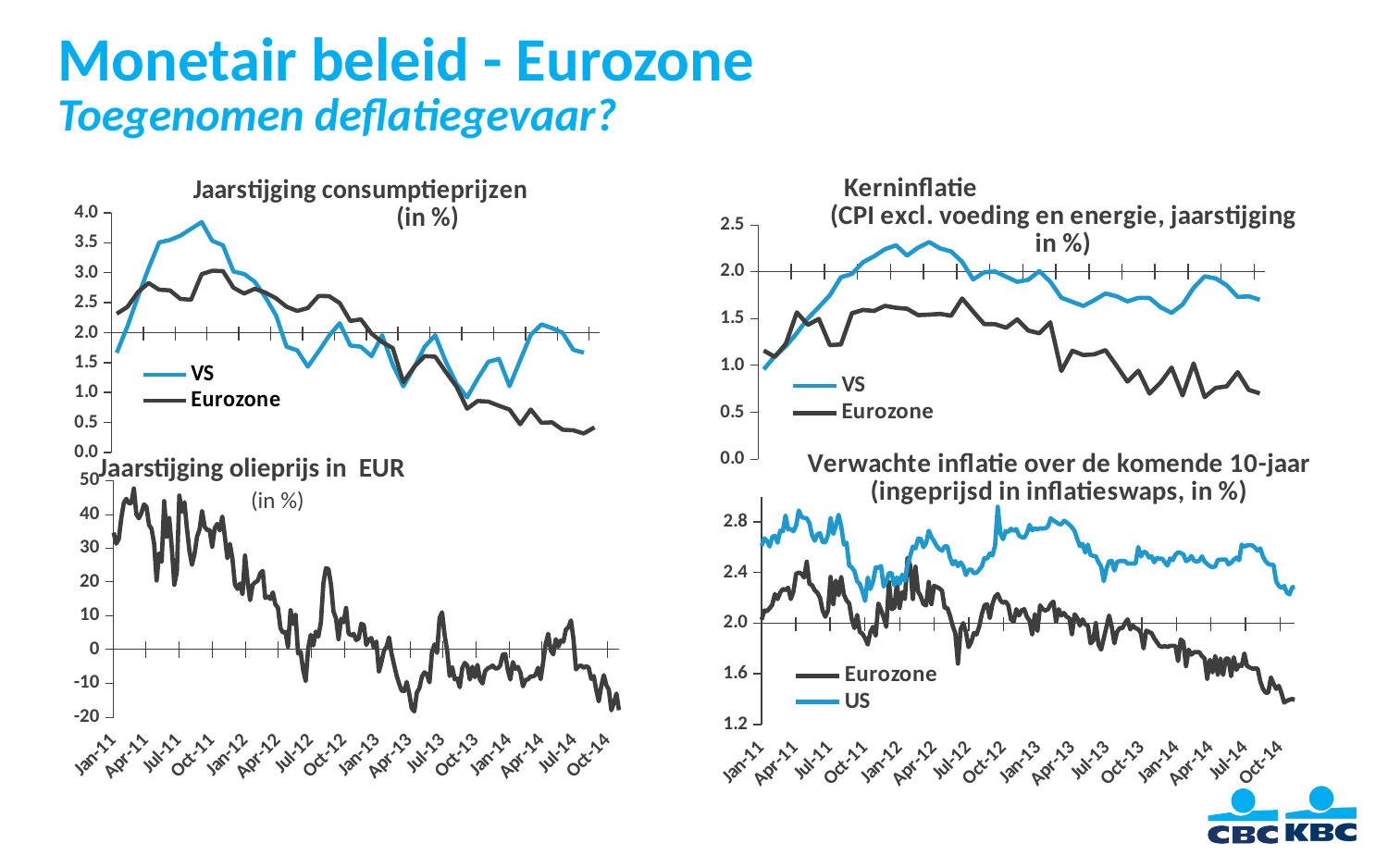
In the 'Jaarstijging olieprijs in EUR' chart, is the value at Jan-11 greater or less than 20? greater In the 'Kerninflatie' chart, is the Eurozone value at Oct-14 greater or less than 1.0? less In the 'Jaarstijging consumptieprijzen (in %)' chart, does the Eurozone series overall rise or fall from Jan-11 to Oct-14? fall In the 'Kerninflatie' chart, which series has the higher value at Oct-14, VS or Eurozone? VS In the 'Verwachte inflatie over de komende 10-jaar' chart, is the US value at Oct-14 greater or less than 2.0? greater Which series are listed in the legend of the 'Verwachte inflatie over de komende 10-jaar' chart? Eurozone and US What kind of chart is the 'Jaarstijging consumptieprijzen (in %)' chart? line chart How many series does the legend of the 'Kerninflatie' chart list? 2 What kind of chart is the 'Verwachte inflatie over de komende 10-jaar' chart? line chart In the 'Jaarstijging olieprijs in EUR' chart, do the values overall rise or fall from Jan-11 to Oct-14? fall In the 'Verwachte inflatie over de komende 10-jaar' chart, which series is higher at Oct-14, Eurozone or US? US